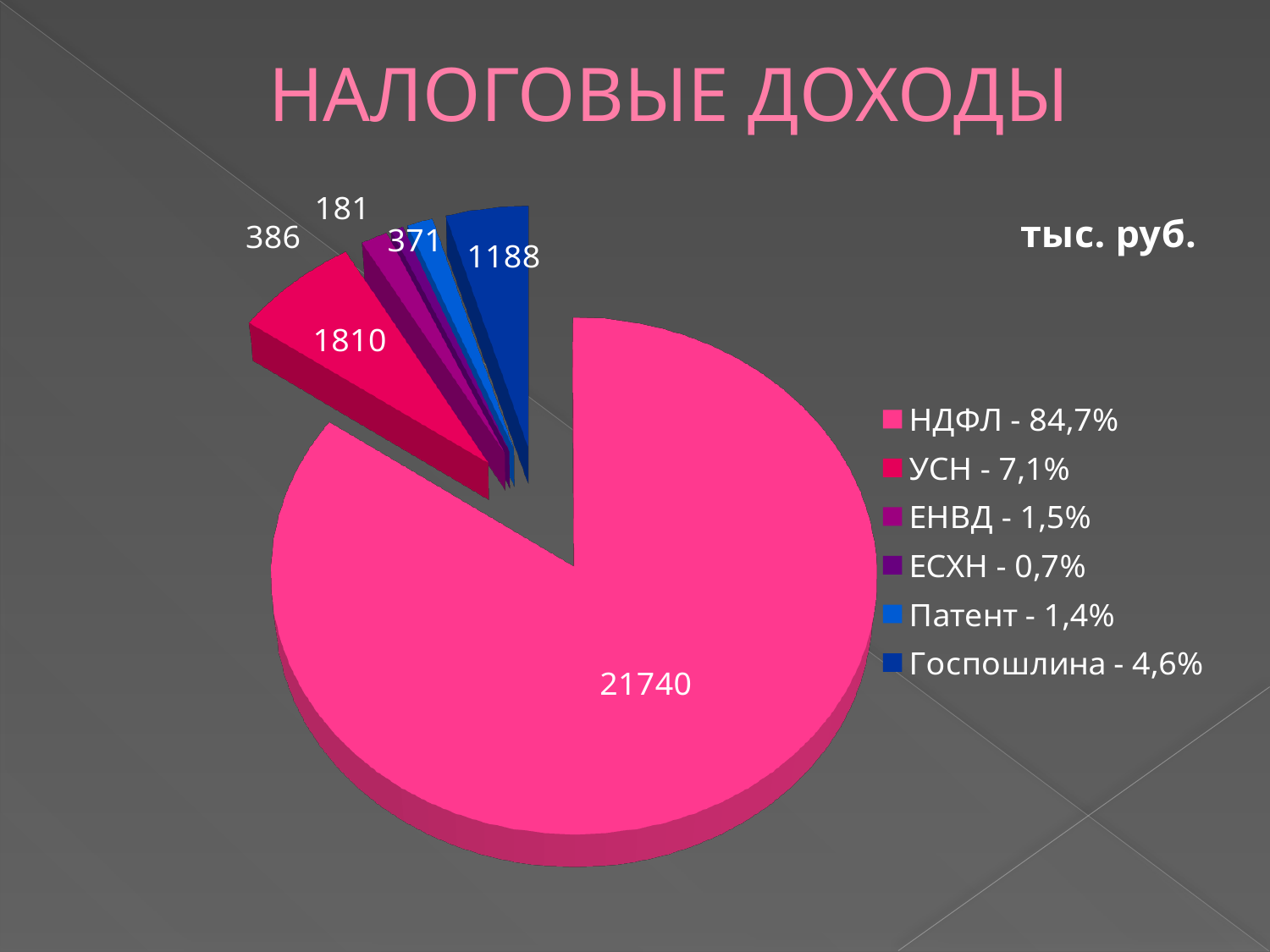
Which is larger, the ЕНВД slice or the Патент slice? ЕНВД What type of chart is shown on the slide? pie chart Which category has the smallest slice? ЕСХН What is the value of the УСН slice? 1810 What share of the pie does Госпошлина represent, according to the legend? 4,6% What is the value of the Госпошлина slice? 1188 How many slices does the pie chart have? 6 What is the difference between the УСН value and the Госпошлина value? 622 What is the title of the chart? тыс. руб. What is the value of the ЕСХН slice? 181 What is the value of the НДФЛ slice? 21740 Which category has the largest slice? НДФЛ